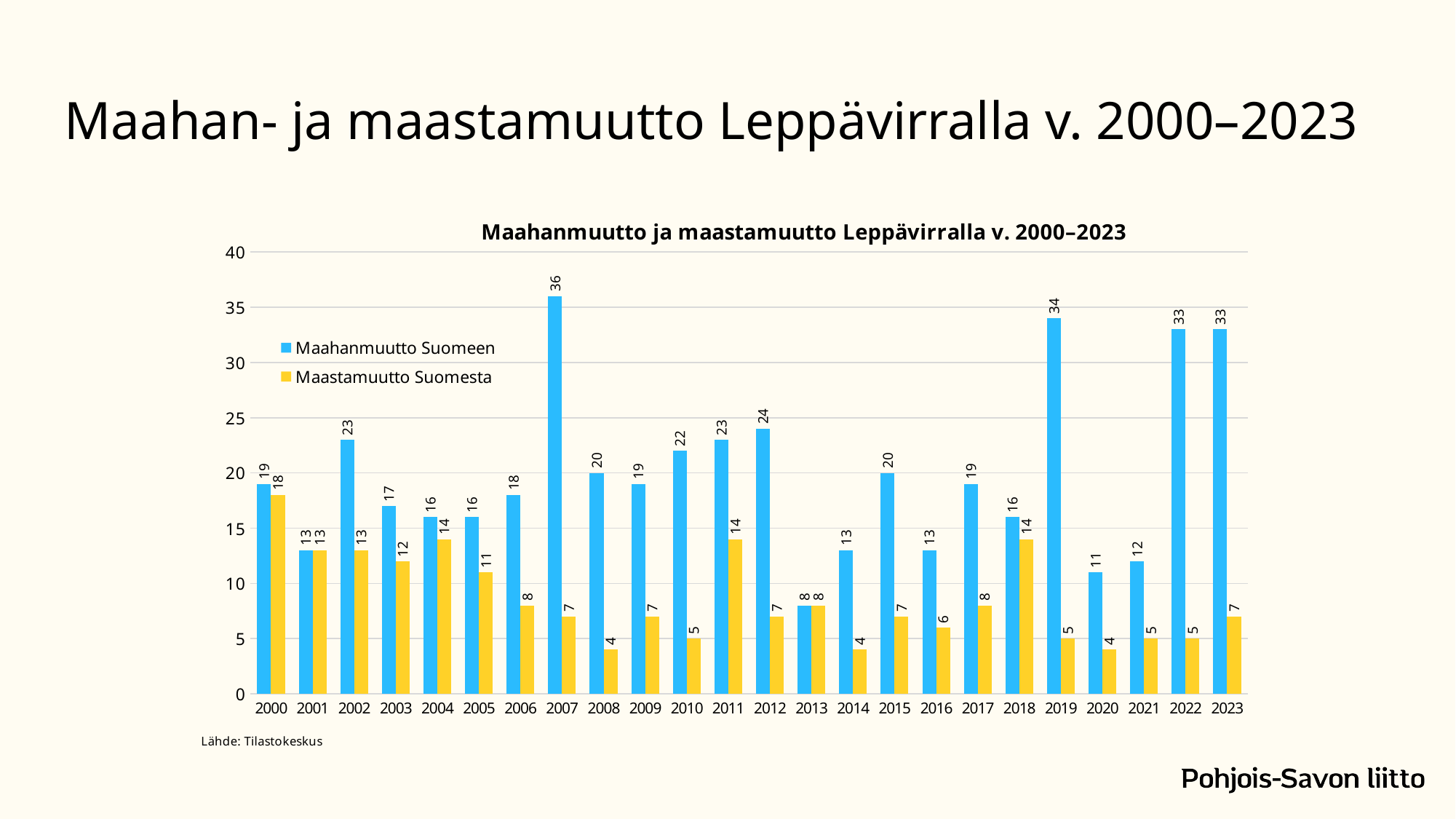
How many years are shown on the x axis? 24 How many series does the legend list? 2 What is the value for Maahanmuutto Suomeen in 2007? 36 What kind of chart is shown on the slide? Bar chart Which year has the highest value for Maahanmuutto Suomeen? 2007 What is the source cited below the chart? Tilastokeskus Which year has the highest value for Maastamuutto Suomesta? 2000 What is the value for Maahanmuutto Suomeen in 2020? 11 Which year has the lowest value for Maahanmuutto Suomeen? 2013 Which is larger in 2004: Maahanmuutto Suomeen or Maastamuutto Suomesta? Maahanmuutto Suomeen What is the value for Maastamuutto Suomesta in 2011? 14 What is the difference between Maahanmuutto Suomeen and Maastamuutto Suomesta in 2019? 29